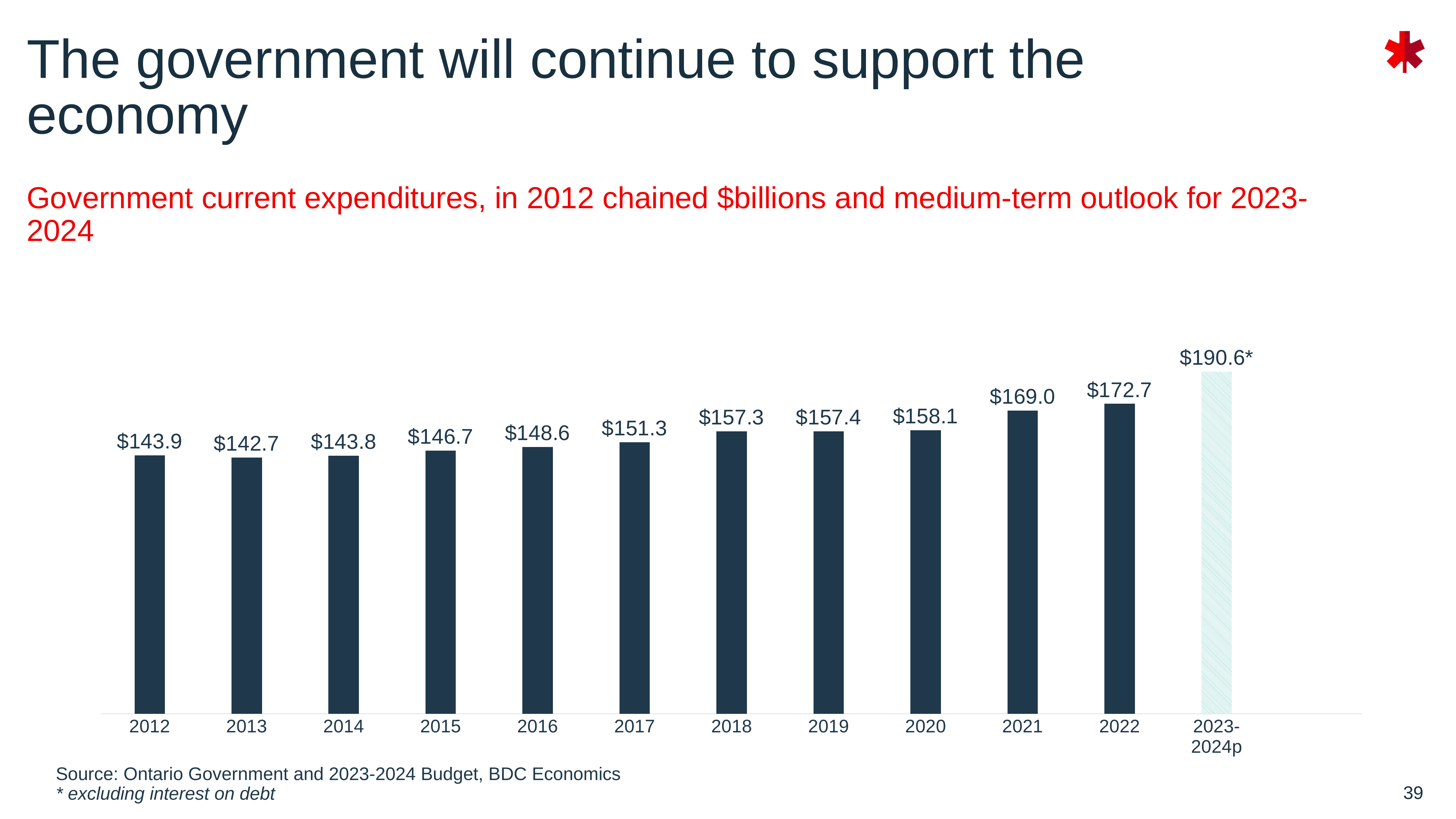
What is the difference between the values for 2023-2024p and 2022? $17.9 What is the difference between the values for 2022 and 2021? $3.7 Which category has the highest value? 2023-2024p Which is larger, the value for 2016 or the value for 2020? 2020 Which year has the lowest value? 2013 What is the value for 2022? $172.7 How many bars are shown in the chart? 12 What kind of chart is shown on the slide? Bar chart Do the values generally rise or fall from 2013 to 2023-2024p? Rise What is the value for 2012? $143.9 What is the value for 2017? $151.3 What is the value shown for 2023-2024p? $190.6*